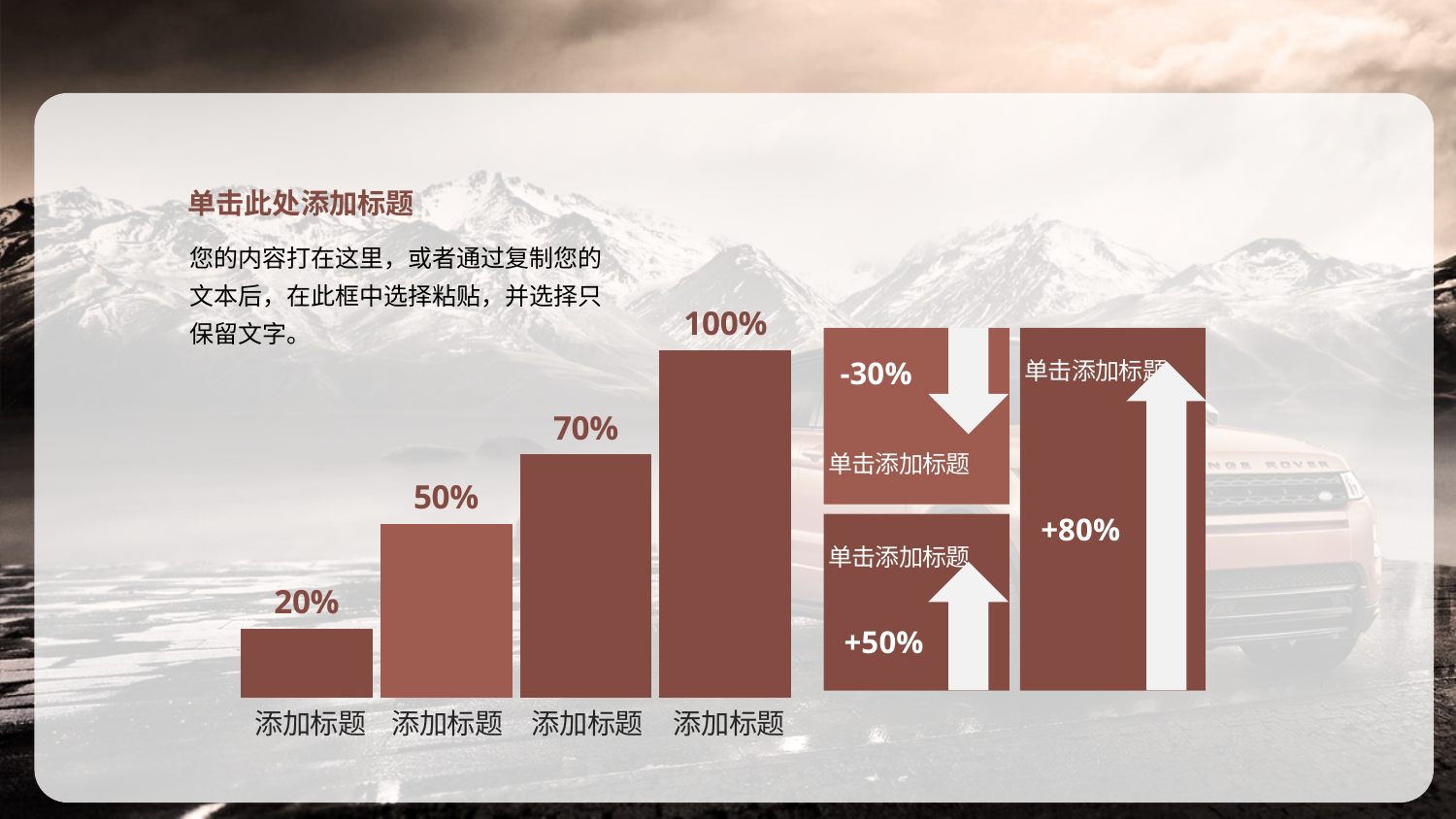
Which bar in the bar chart has the highest value? the fourth (rightmost) bar, 100% What is the value of the fourth (rightmost) bar in the bar chart? 100% Which bar in the bar chart has the lowest value? the first (leftmost) bar, 20% Do the bar values rise or fall from left to right in the bar chart? rise How many bars are in the bar chart? 4 What is the difference between the third bar and the second bar in the bar chart? 20% What is the value of the first (leftmost) bar in the bar chart? 20% What is the value of the third bar from the left in the bar chart? 70% Which is larger in the bar chart, the second bar or the third bar? the third bar (70%) What is the value of the second bar from the left in the bar chart? 50% What type of chart is shown on the slide? bar chart What is the difference between the rightmost bar and the leftmost bar in the bar chart? 80%